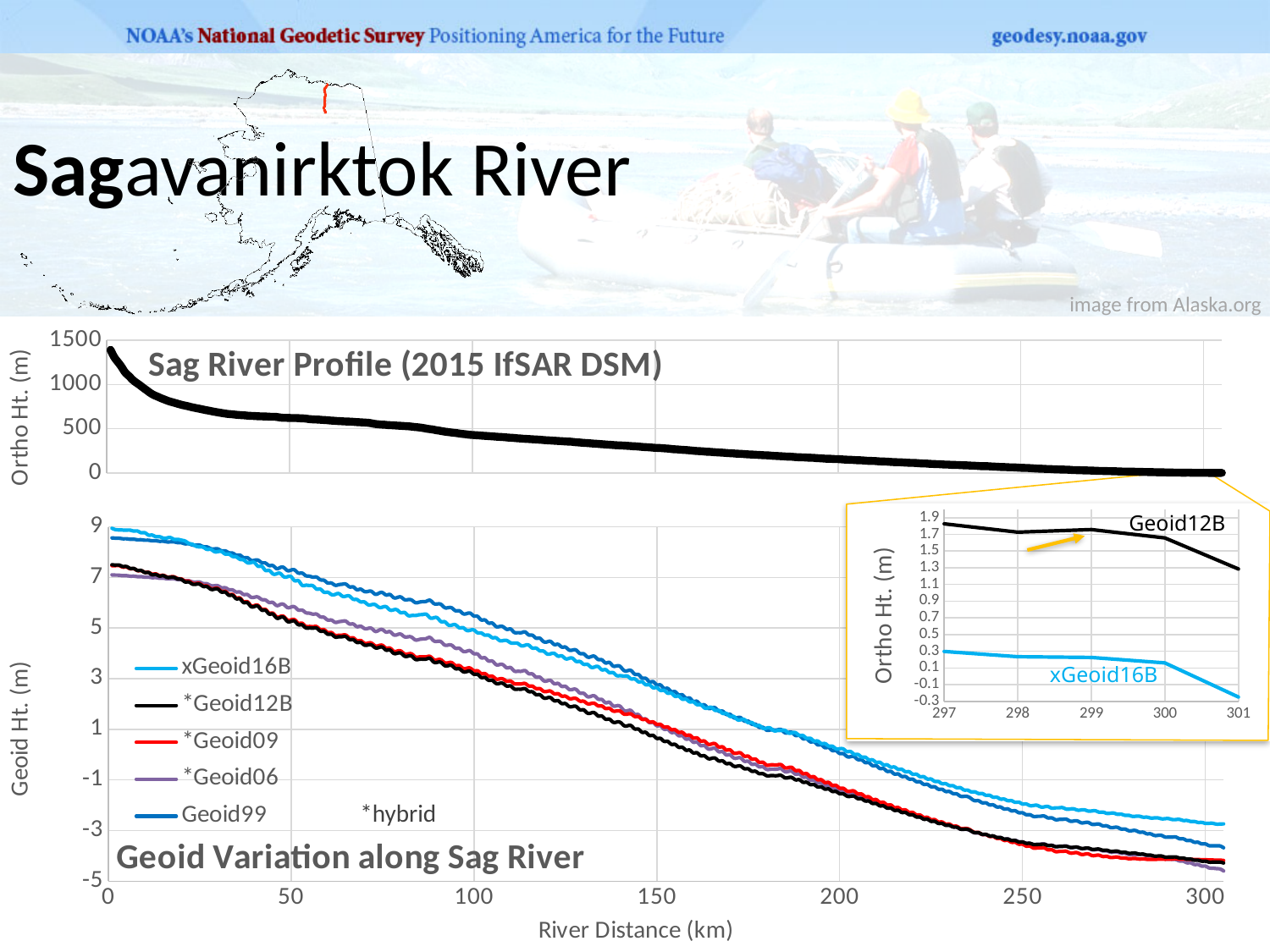
In the inset chart at the right, which series is higher at 297 km, Geoid12B or xGeoid16B? Geoid12B How many series does the legend of "Geoid Variation along Sag River" list? 5 In "Geoid Variation along Sag River", which series is higher at 300 km, xGeoid16B or *Geoid06? xGeoid16B In "Sag River Profile (2015 IfSAR DSM)", is the ortho height at 150 km greater or less than 500? less What kind of chart is "Geoid Variation along Sag River"? line chart In "Geoid Variation along Sag River", is the *Geoid12B value at 300 km greater or less than -3? less In "Sag River Profile (2015 IfSAR DSM)", is the ortho height at 0 km greater or less than 1000? greater What is the x-axis title of "Geoid Variation along Sag River"? River Distance (km) In "Sag River Profile (2015 IfSAR DSM)", do the values rise or fall as river distance increases? fall In "Geoid Variation along Sag River", do the geoid heights rise or fall along the x axis? fall In "Geoid Variation along Sag River", which series is higher at 0 km, xGeoid16B or *Geoid12B? xGeoid16B